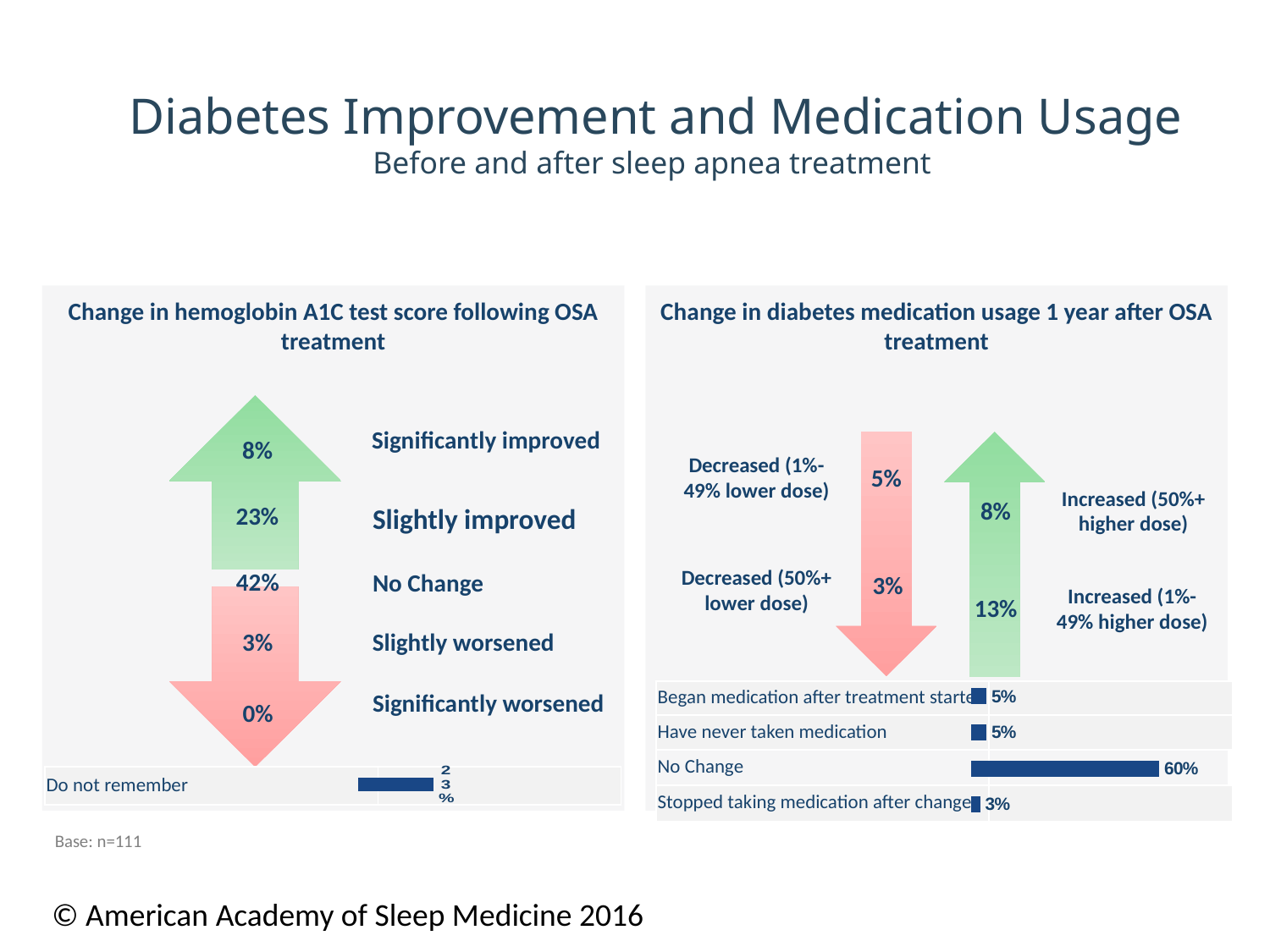
In the 'Change in diabetes medication usage 1 year after OSA treatment' bar chart, what is the value for 'No Change'? 60% In the 'Change in hemoglobin A1C test score following OSA treatment' bar chart, what is the value for 'Do not remember'? 23% In the 'Change in diabetes medication usage 1 year after OSA treatment' bar chart, what is the difference between 'No Change' and 'Began medication after treatment started'? 55% In the 'Change in diabetes medication usage 1 year after OSA treatment' bar chart, what is the value for 'Have never taken medication'? 5% In the 'Change in diabetes medication usage 1 year after OSA treatment' bar chart, how many categories are shown? 4 In the 'Change in diabetes medication usage 1 year after OSA treatment' bar chart, which category has the lowest value? Stopped taking medication after change In the 'Change in diabetes medication usage 1 year after OSA treatment' bar chart, what is the value for 'Stopped taking medication after change'? 3% In the 'Change in hemoglobin A1C test score following OSA treatment' panel, what percentage is shown for 'No Change'? 42% What kind of chart is used at the bottom of the 'Change in diabetes medication usage 1 year after OSA treatment' panel? Bar chart In the 'Change in diabetes medication usage 1 year after OSA treatment' panel, what percentage is shown for 'Increased (1%-49% higher dose)'? 13% In the 'Change in hemoglobin A1C test score following OSA treatment' panel, which is larger: 'Slightly improved' or 'Slightly worsened'? Slightly improved In the 'Change in diabetes medication usage 1 year after OSA treatment' bar chart, which category has the highest value? No Change